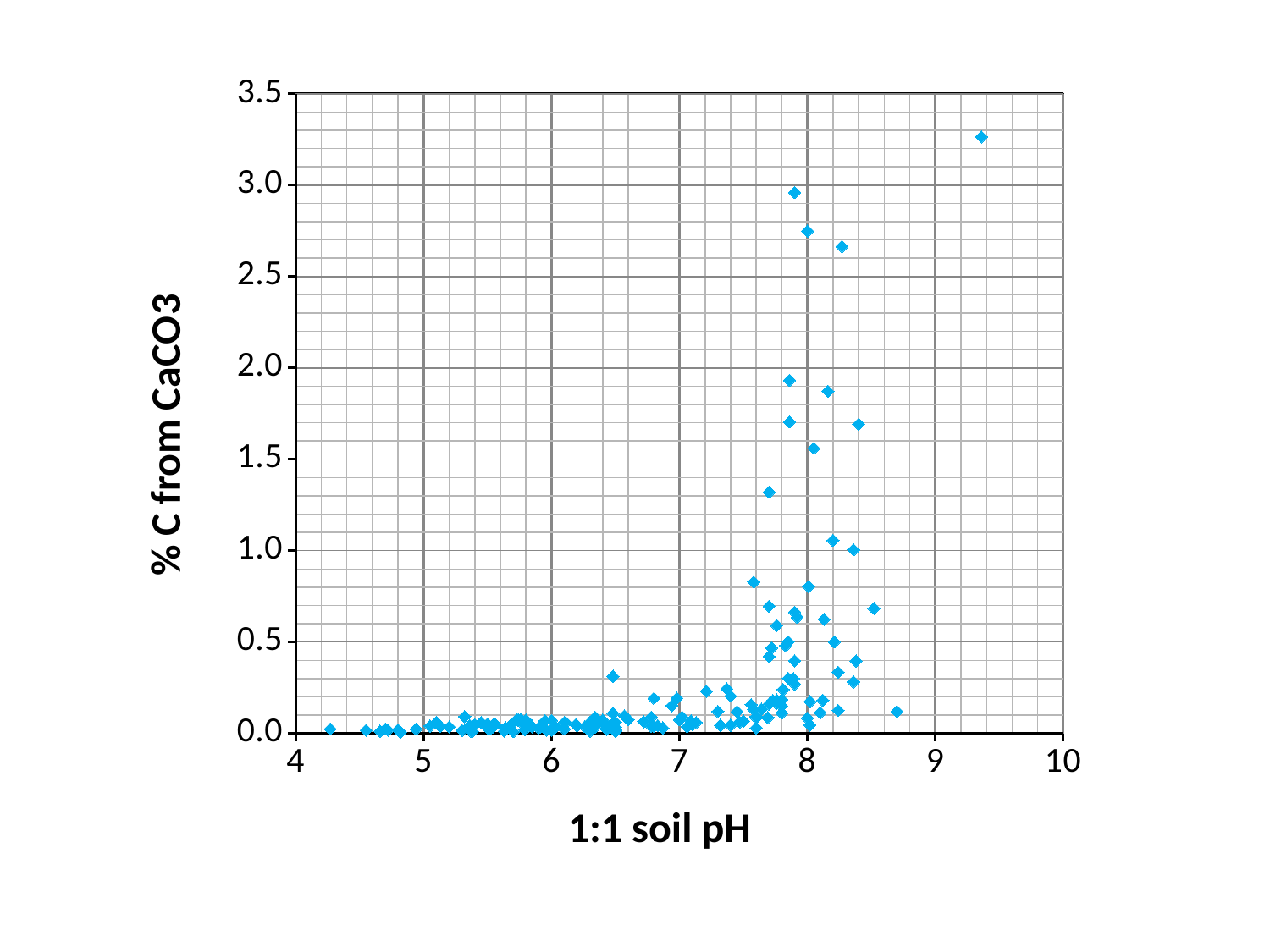
Are the % C from CaCO3 values for points with soil pH below 6 greater or less than 0.5? less What is the label of the x axis? 1:1 soil pH What is the label of the y axis? % C from CaCO3 What kind of chart is shown on the slide? scatter plot Is the highest % C from CaCO3 value plotted greater or less than 3.0? greater Is the highest % C from CaCO3 value plotted greater or less than 3.5? less Do the % C from CaCO3 values generally rise or fall as soil pH increases along the x axis? rise